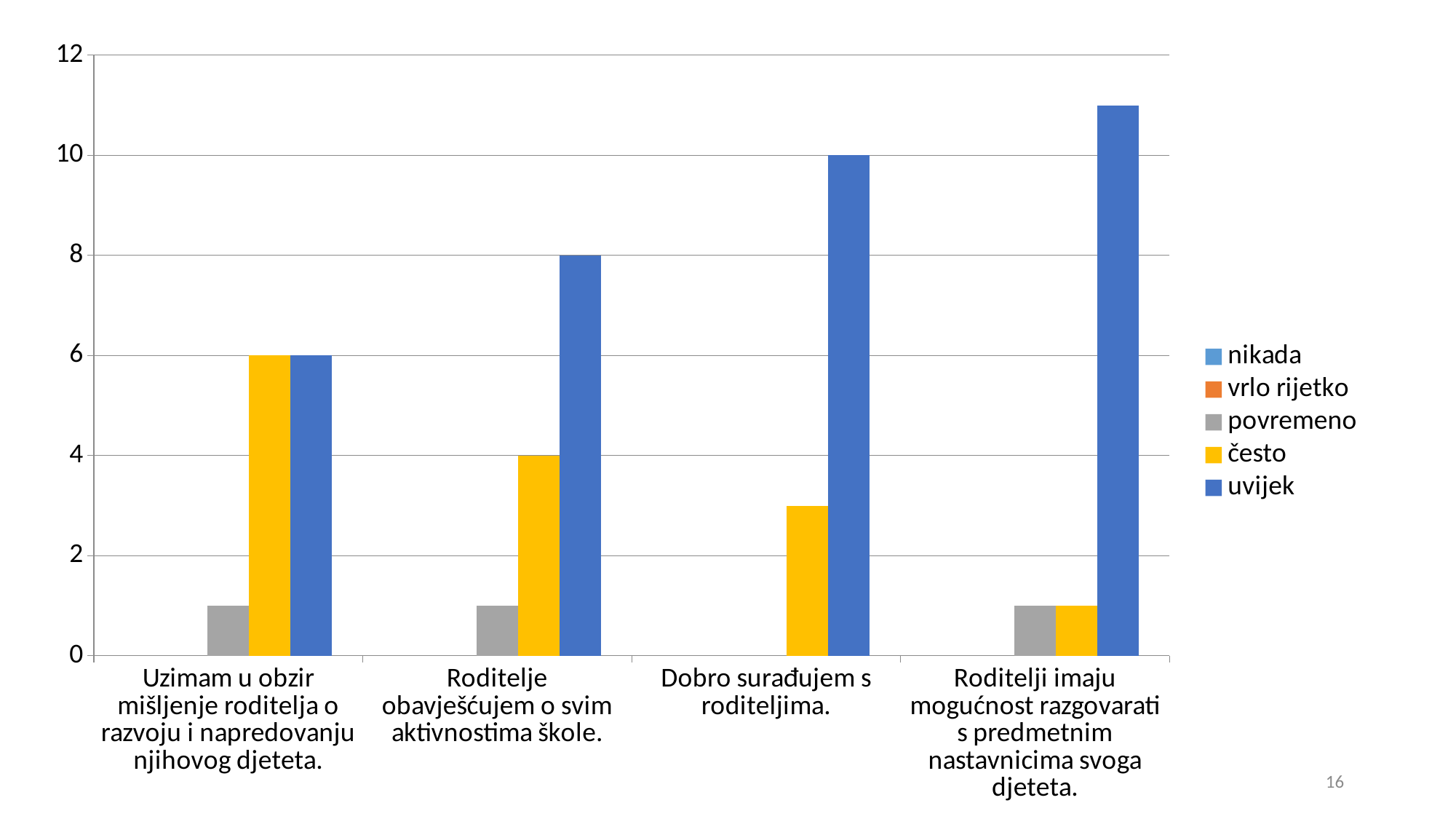
What is the value of "uvijek" for "Roditelje obavješćujem o svim aktivnostima škole."? 8 Which has a larger "uvijek" value: "Dobro surađujem s roditeljima." or "Roditelje obavješćujem o svim aktivnostima škole."? Dobro surađujem s roditeljima. How many series does the legend list? 5 What is the value of "uvijek" for "Dobro surađujem s roditeljima."? 10 For "Roditelje obavješćujem o svim aktivnostima škole.", how much larger is "uvijek" than "često"? 4 Which category has the highest "uvijek" value? Roditelji imaju mogućnost razgovarati s predmetnim nastavnicima svoga djeteta. What is the value of "često" for "Uzimam u obzir mišljenje roditelja o razvoju i napredovanju njihovog djeteta."? 6 How many categories are shown on the x axis? 4 Is the value of "često" for "Dobro surađujem s roditeljima." greater or less than 4? less What kind of chart is shown on the slide? bar chart Is the value of "uvijek" for "Roditelji imaju mogućnost razgovarati s predmetnim nastavnicima svoga djeteta." greater or less than 10? greater What is the value of "često" for "Roditelje obavješćujem o svim aktivnostima škole."? 4